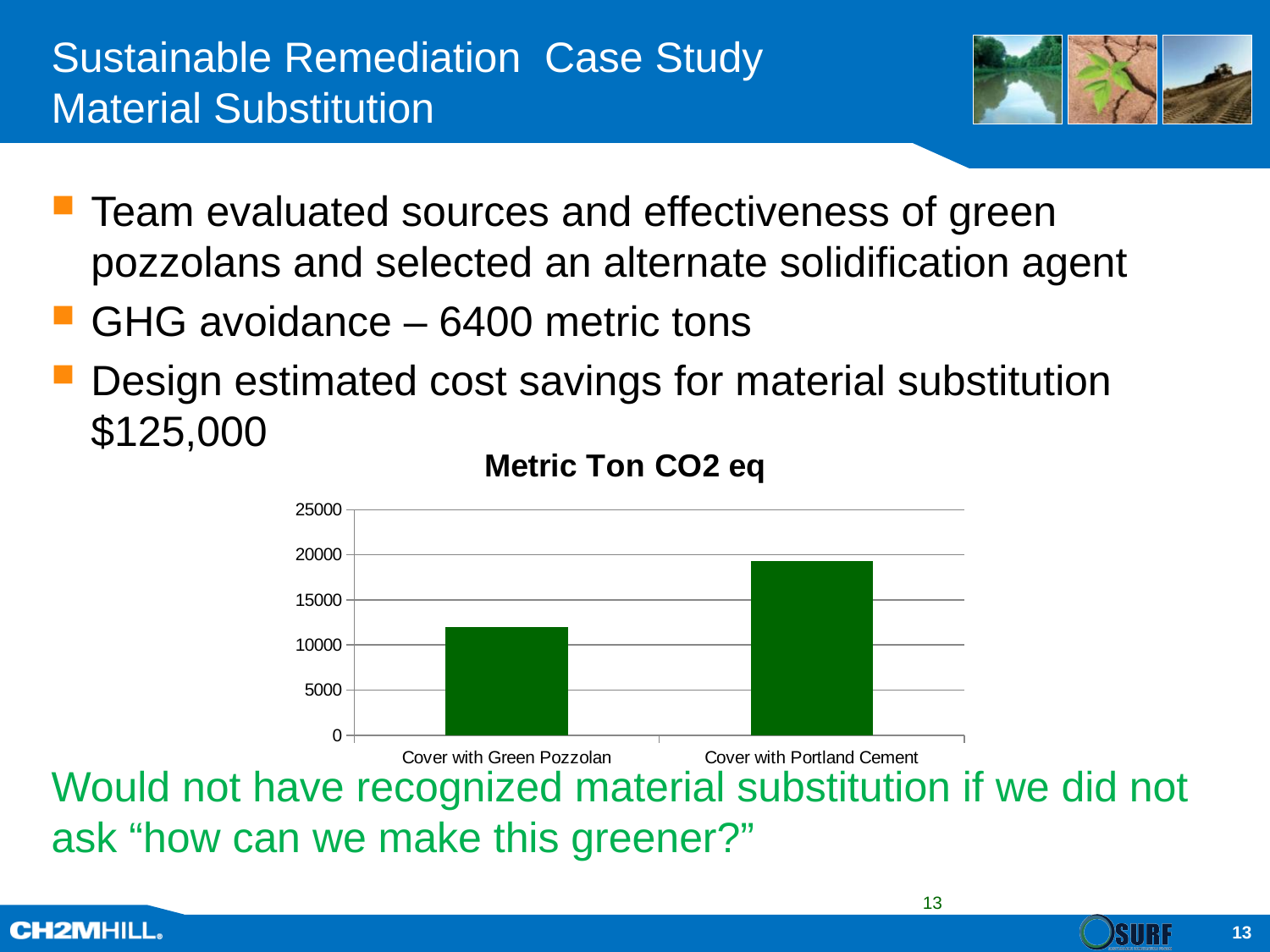
Which is larger, the value for Cover with Green Pozzolan or the value for Cover with Portland Cement? Cover with Portland Cement What is the title of the chart? Metric Ton CO2 eq Is the value for Cover with Portland Cement greater or less than 15000? greater Is the value for Cover with Green Pozzolan greater or less than 15000? less Which category has the highest value in the chart? Cover with Portland Cement What kind of chart is shown on the slide? bar chart Is the value for Cover with Green Pozzolan greater or less than 10000? greater How many categories are plotted in the chart? 2 Which category has the lowest value in the chart? Cover with Green Pozzolan What colour are the bars in the chart? green Do the values rise or fall from left to right across the categories? rise